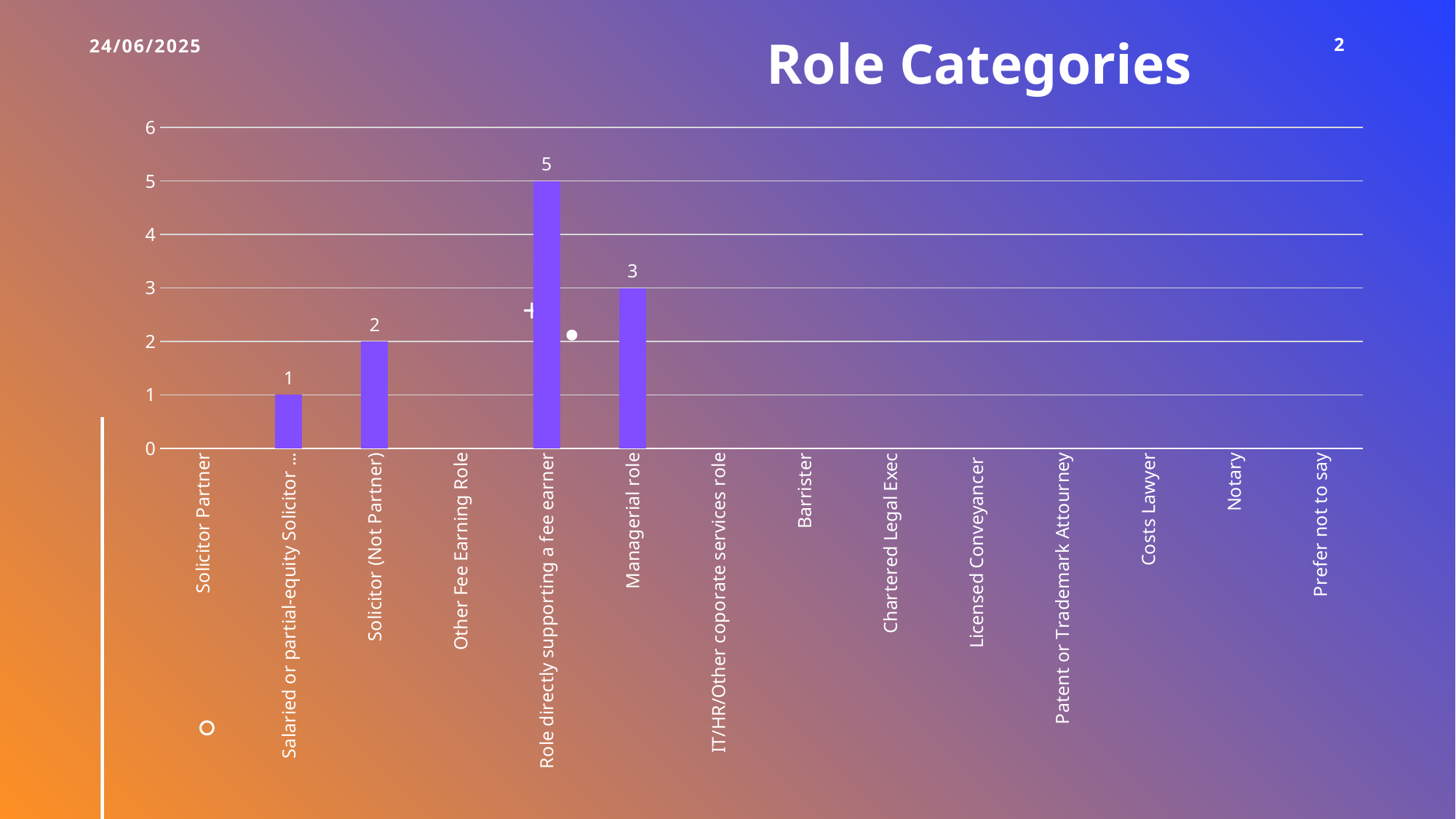
What is the difference between the values for Role directly supporting a fee earner and Managerial role? 2 What is the total of the values for Solicitor (Not Partner) and Managerial role? 5 Which category has the highest value? Role directly supporting a fee earner What is the value for Solicitor (Not Partner)? 2 What is the title of the chart? Role Categories What is the value for Managerial role? 3 What is the value for Role directly supporting a fee earner? 5 What type of chart is shown on the slide? bar chart How many categories have a visible bar with a data label? 4 Is the value for Role directly supporting a fee earner greater or less than 4? greater How many categories are listed on the x axis? 14 Which is larger, the value for Solicitor (Not Partner) or the value for Managerial role? Managerial role